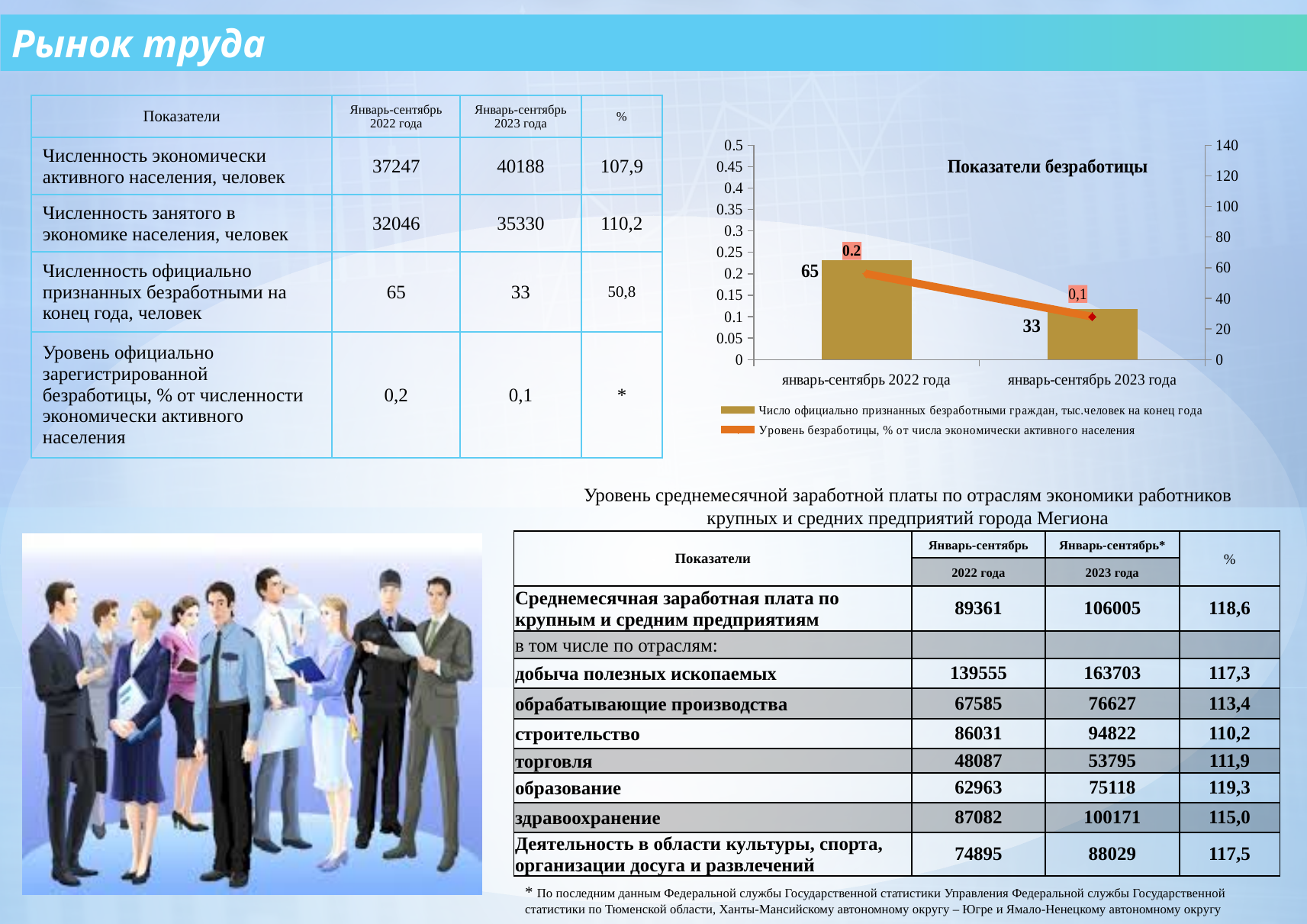
In the chart 'Показатели безработицы', what is the number of officially recognised unemployed citizens (thousand people) for январь-сентябрь 2022 года? 65 In the chart 'Показатели безработицы', what is the unemployment rate (% of the economically active population) for январь-сентябрь 2022 года? 0.2 In the chart 'Показатели безработицы', which period has the lower unemployment rate? январь-сентябрь 2023 года In the chart 'Показатели безработицы', what is the unemployment rate (% of the economically active population) for январь-сентябрь 2023 года? 0,1 How many periods (categories) are shown on the x axis of the chart 'Показатели безработицы'? 2 What kind of chart is 'Показатели безработицы'? A bar chart combined with a line In the chart 'Показатели безработицы', which period has the higher number of officially recognised unemployed citizens? январь-сентябрь 2022 года In the chart 'Показатели безработицы', does the unemployment rate rise or fall from январь-сентябрь 2022 года to январь-сентябрь 2023 года? It falls In the chart 'Показатели безработицы', what is the number of officially recognised unemployed citizens (thousand people) for январь-сентябрь 2023 года? 33 In the chart 'Показатели безработицы', is the bar for январь-сентябрь 2023 года greater or less than 40 on the right-hand axis? less How many series does the legend of the chart 'Показатели безработицы' list? 2 In the chart 'Показатели безработицы', by how much did the number of officially recognised unemployed citizens fall from январь-сентябрь 2022 года to январь-сентябрь 2023 года? 32